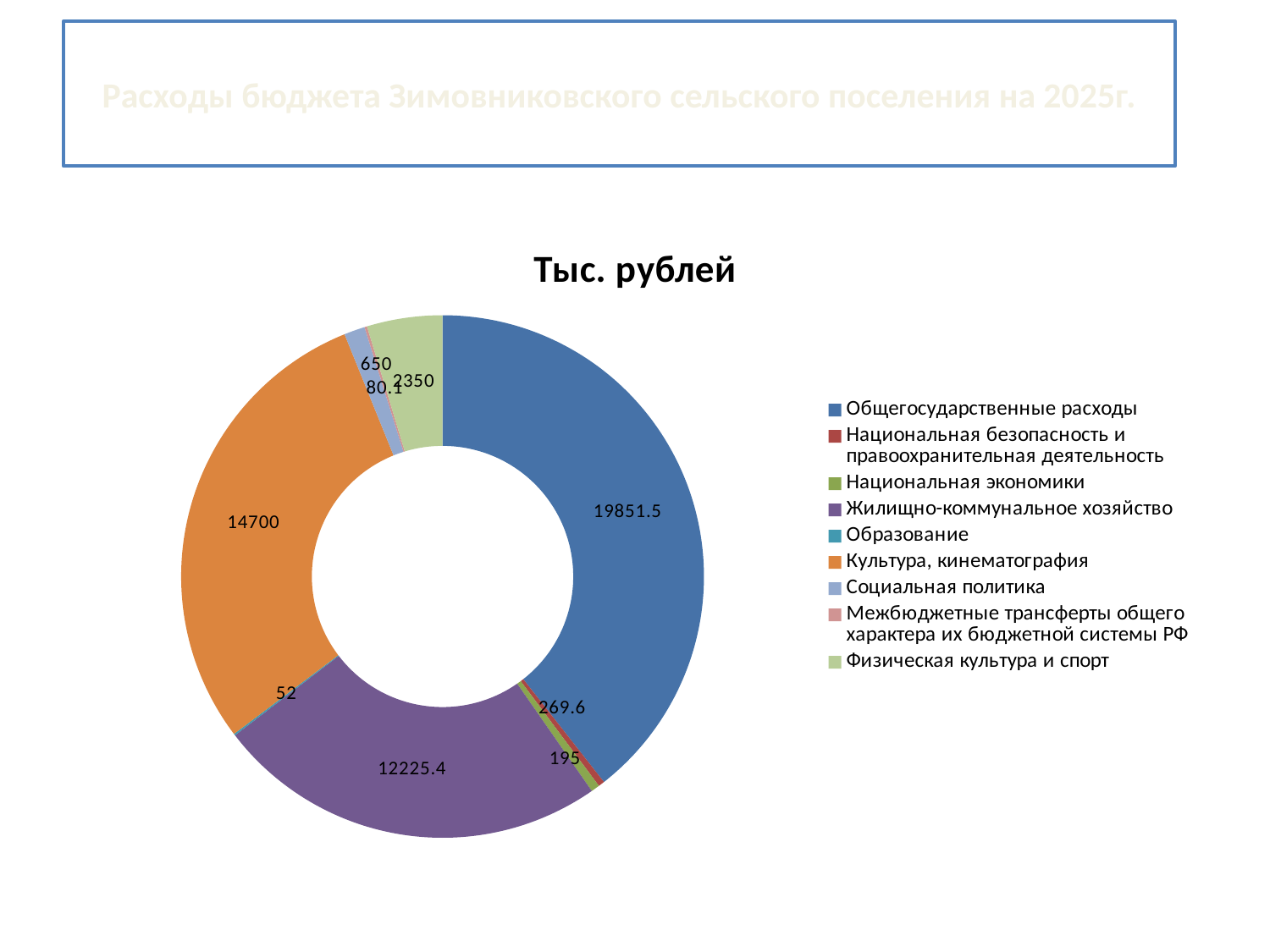
What is the value for Общегосударственные расходы? 19851.5 Which category has the largest value? Общегосударственные расходы What is the value for Физическая культура и спорт? 2350 What is the title of the chart? Тыс. рублей What kind of chart is shown? Doughnut (pie) chart Which category has the smallest value? Образование What is the value for Образование? 52 Which is larger, the value for Социальная политика or the value for Национальная безопасность и правоохранительная деятельность? Социальная политика How many categories does the legend list? 9 What is the value for Культура, кинематография? 14700 What is the value for Жилищно-коммунальное хозяйство? 12225.4 What is the difference between the values for Общегосударственные расходы and Культура, кинематография? 5151.5